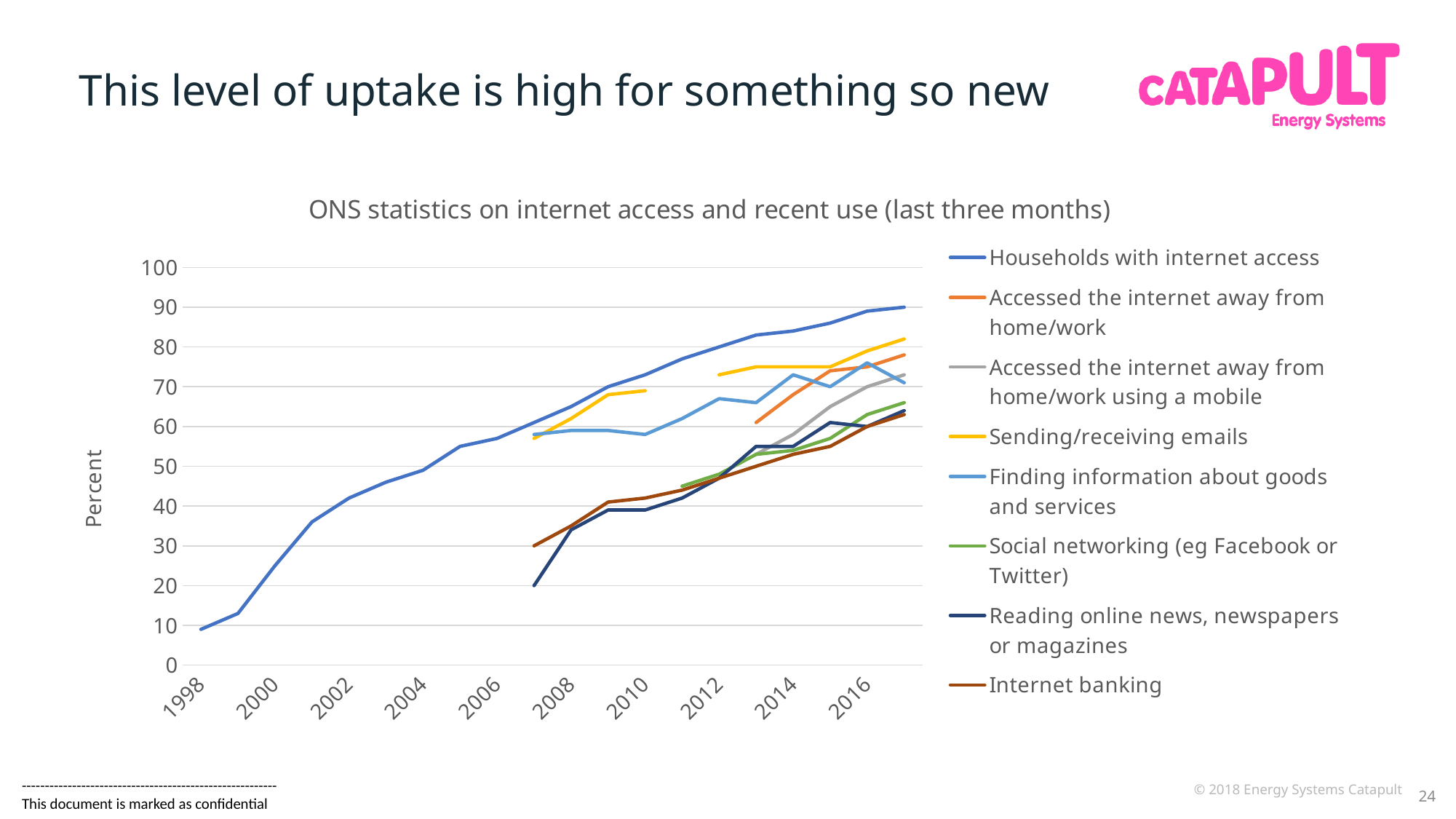
What kind of chart is shown on the slide? Line chart In 2014, which is larger: Finding information about goods and services or Internet banking? Finding information about goods and services Is the value for Households with internet access in 2000 greater or less than 20? greater Is the value for Households with internet access in 2016 greater or less than 80? greater What is the label on the vertical axis? Percent In 2017, which is larger: Households with internet access or Sending/receiving emails? Households with internet access What is the title of the chart? ONS statistics on internet access and recent use (last three months) Which series has the highest value in 2016? Households with internet access Is the value for Social networking (eg Facebook or Twitter) in 2017 greater or less than 60? greater Does the value for Households with internet access rise or fall from 1998 to 2017? Rise Which series has the lowest value in 2010? Reading online news, newspapers or magazines How many series does the legend list? 8